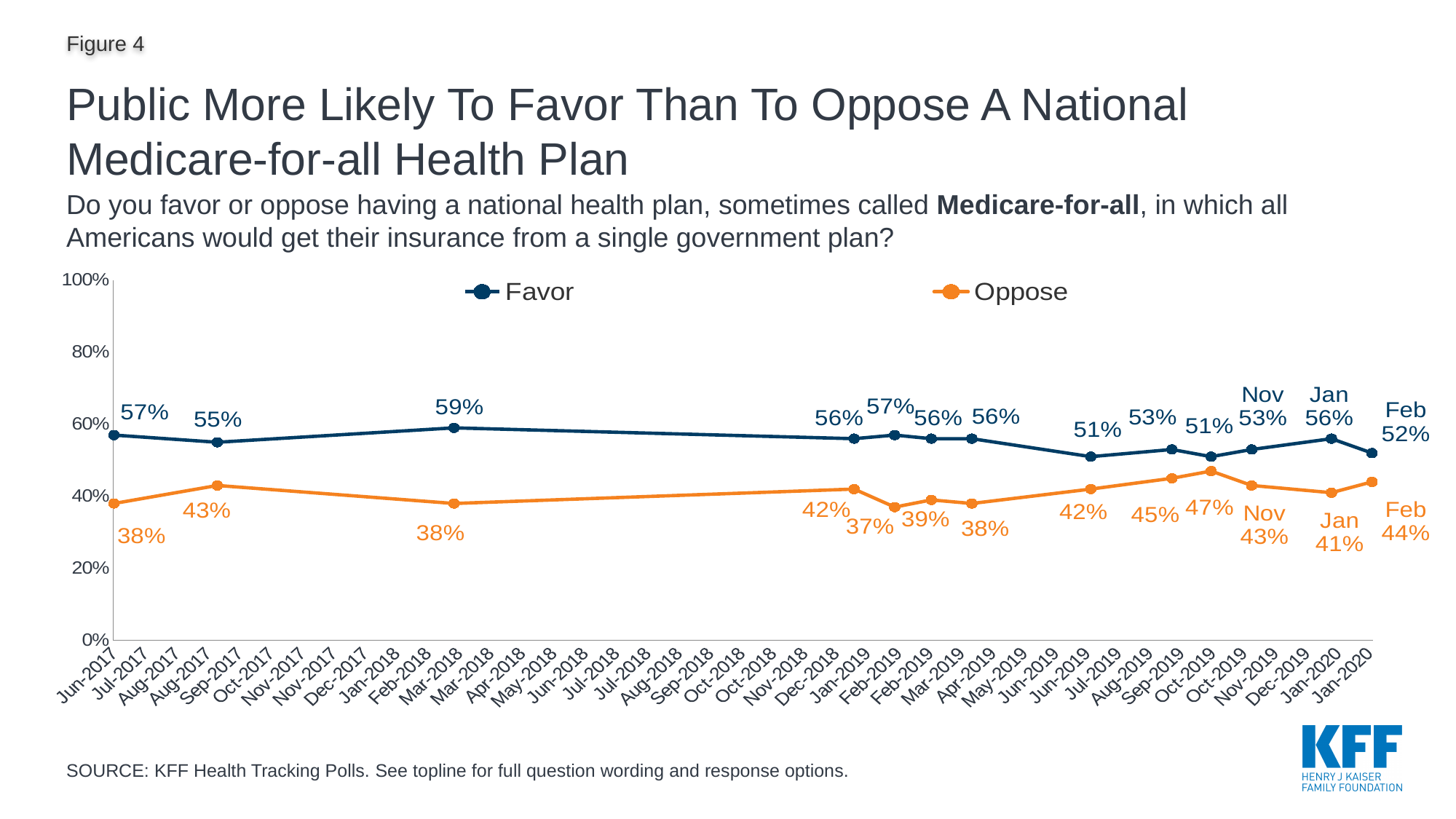
In Nov 2019, which is larger, Favor or Oppose? Favor What is the Favor value for Feb 2020? 52% What is the highest value shown for the Oppose series? 47% What is the difference between the Favor and Oppose values for Feb 2020? 8 percentage points What kind of chart is shown on the slide? line chart What is the highest value shown for the Favor series? 59% How many data points are plotted for the Favor series? 13 What is the lowest value shown for the Oppose series? 37% What is the Favor value for Nov 2019? 53% What is the difference between the Favor and Oppose values for Jan 2020? 15 percentage points What is the Oppose value for Jan 2020? 41% How many series does the legend list? 2